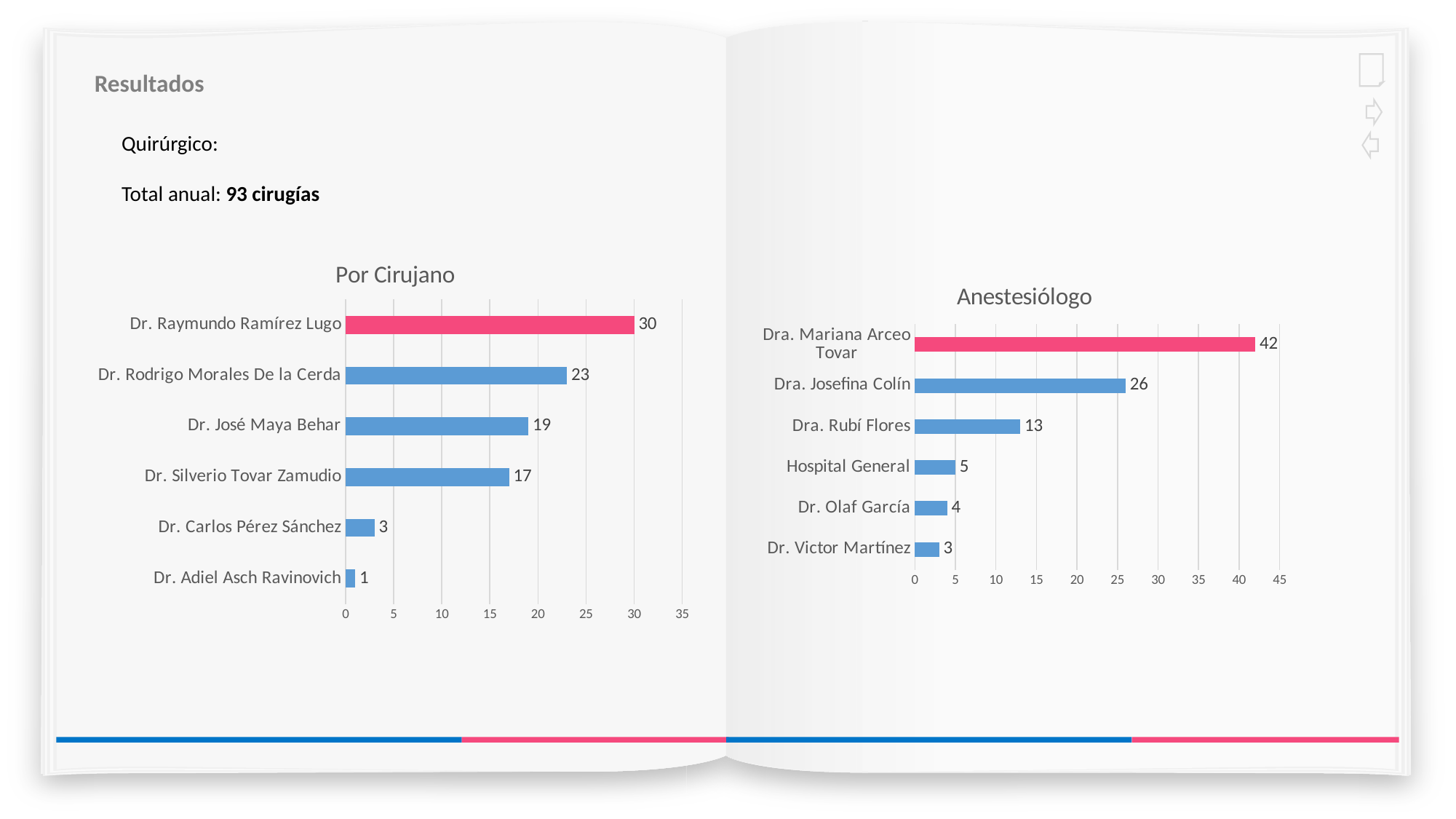
In the 'Anestesiólogo' chart, is the value for Dra. Mariana Arceo Tovar greater or less than 40? greater In the 'Por Cirujano' chart, what is the difference between Dr. Raymundo Ramírez Lugo and Dr. José Maya Behar? 11 In the 'Anestesiólogo' chart, which category has the lowest value? Dr. Victor Martínez In the 'Anestesiólogo' chart, what is the value for Dra. Rubí Flores? 13 In the 'Por Cirujano' chart, which is larger: the value for Dr. Silverio Tovar Zamudio or Dr. Carlos Pérez Sánchez? Dr. Silverio Tovar Zamudio How many categories are shown in the 'Anestesiólogo' chart? 6 In the 'Anestesiólogo' chart, what colour is the bar for Dra. Mariana Arceo Tovar? Pink What type of chart is the 'Por Cirujano' chart? Bar chart How many surgeons are listed in the 'Por Cirujano' chart? 6 In the 'Por Cirujano' chart, which surgeon has the highest value? Dr. Raymundo Ramírez Lugo In the 'Anestesiólogo' chart, what is the difference between Dra. Mariana Arceo Tovar and Dra. Josefina Colín? 16 In the 'Por Cirujano' chart, what is the value for Dr. Rodrigo Morales De la Cerda? 23